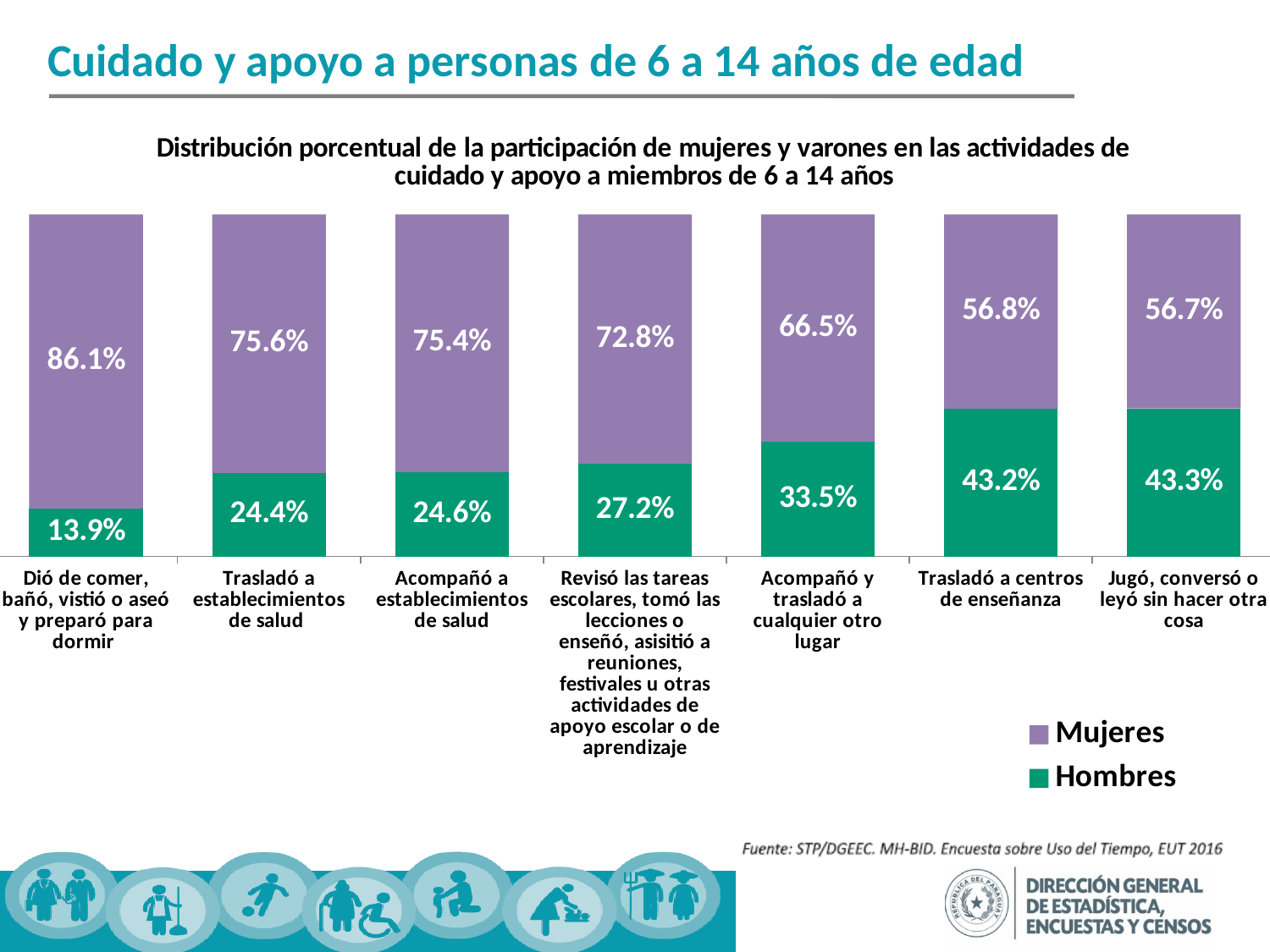
Which category has the lowest Hombres value? Dió de comer, bañó, vistió o aseó y preparó para dormir What kind of chart is shown on the slide? Stacked bar chart What is the Hombres value for "Trasladó a centros de enseñanza"? 43.2% Do the Hombres values rise or fall from left to right along the x axis? Rise What is the Hombres value for "Revisó las tareas escolares, tomó las lecciones o enseñó, asistió a reuniones, festivales u otras actividades de apoyo escolar o de aprendizaje"? 27.2% What is the difference between the Mujeres and Hombres values for "Acompañó y trasladó a cualquier otro lugar"? 33.0% Which is larger: the Hombres value for "Trasladó a establecimientos de salud" or the Hombres value for "Acompañó a establecimientos de salud"? Acompañó a establecimientos de salud Which colour represents Mujeres in the chart? Purple How many series does the legend list? 2 How many categories are shown on the x axis? 7 What is the Mujeres value for "Dió de comer, bañó, vistió o aseó y preparó para dormir"? 86.1% Which category has the highest Mujeres value? Dió de comer, bañó, vistió o aseó y preparó para dormir